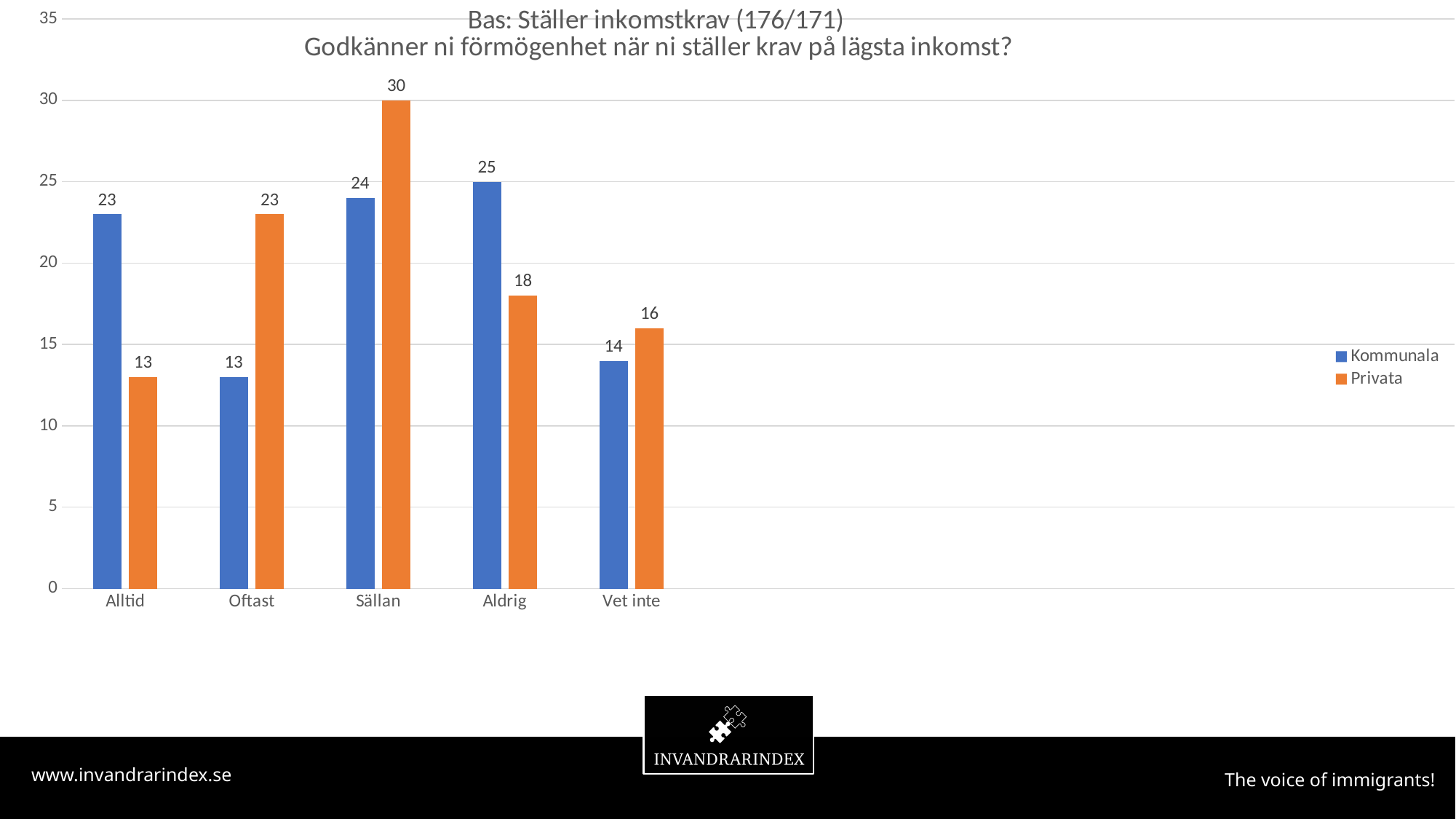
What is the difference between the Privata and Kommunala values in the Aldrig category? 7 Which category has the lowest value for the Kommunala series? Oftast How many series does the legend list? 2 What is the value for Privata in the Sällan category? 30 What is the value for Kommunala in the Alltid category? 23 What colour represents the Privata series? Orange What kind of chart is shown on the slide? Bar chart In the Oftast category, which series has the larger value, Kommunala or Privata? Privata Which category has the highest value for the Privata series? Sällan Is the value for Kommunala in the Aldrig category greater or less than 20? greater How many categories are shown on the x axis? 5 What is the value for Privata in the Vet inte category? 16